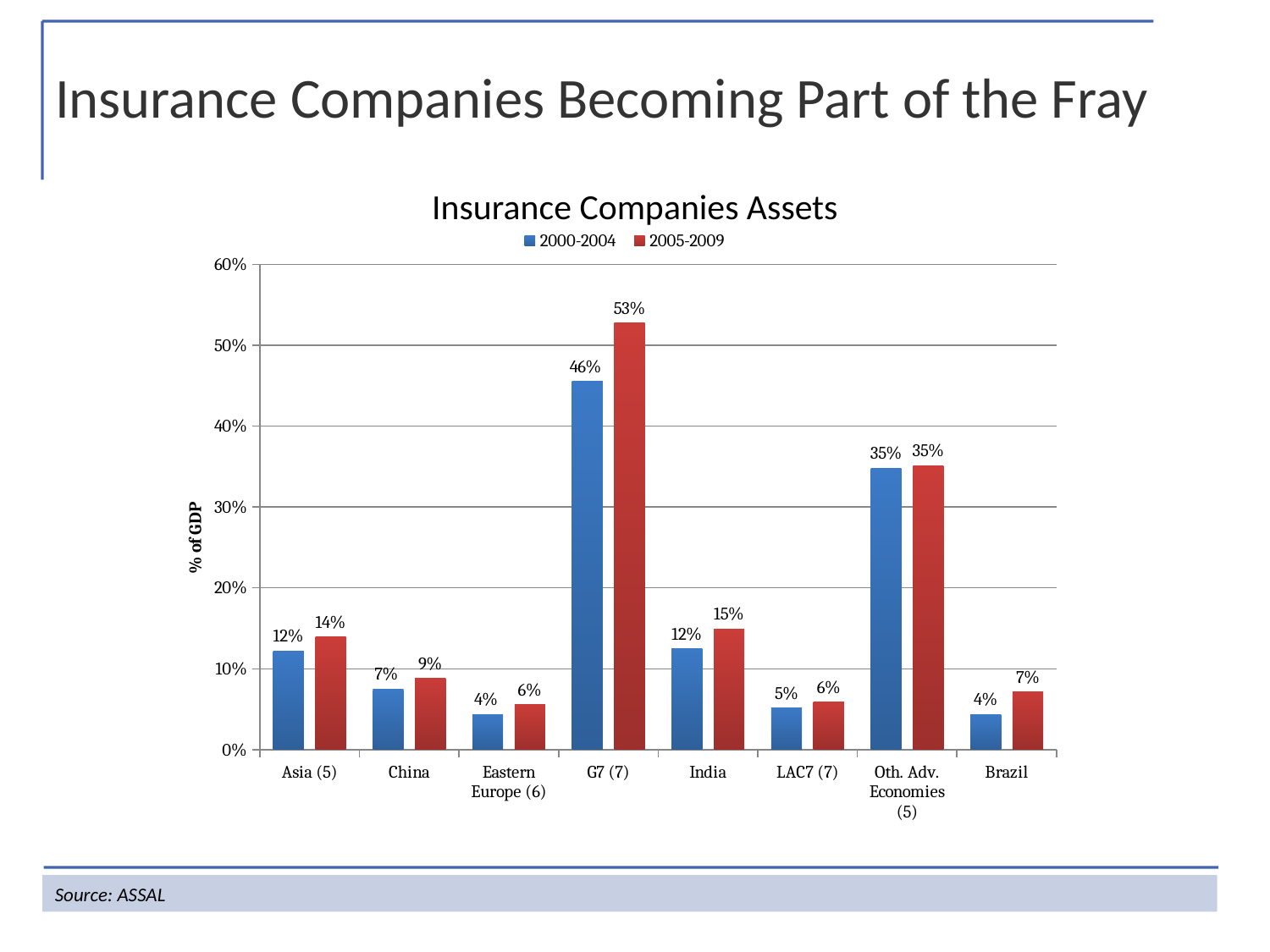
What is the value for Brazil in the 2005-2009 series? 7% What is the title of the chart? Insurance Companies Assets Is the 2005-2009 value for Oth. Adv. Economies (5) greater or less than 30%? greater Which category has the highest value in the 2000-2004 series? G7 (7) Which is larger for China: the 2000-2004 value or the 2005-2009 value? 2005-2009 How many categories are shown on the x axis? 8 What kind of chart is shown on the slide? Bar chart What is the value for G7 (7) in the 2005-2009 series? 53% What is the value for India in the 2000-2004 series? 12% How many series does the legend list? 2 What is the difference between the 2005-2009 and 2000-2004 values for G7 (7)? 7%